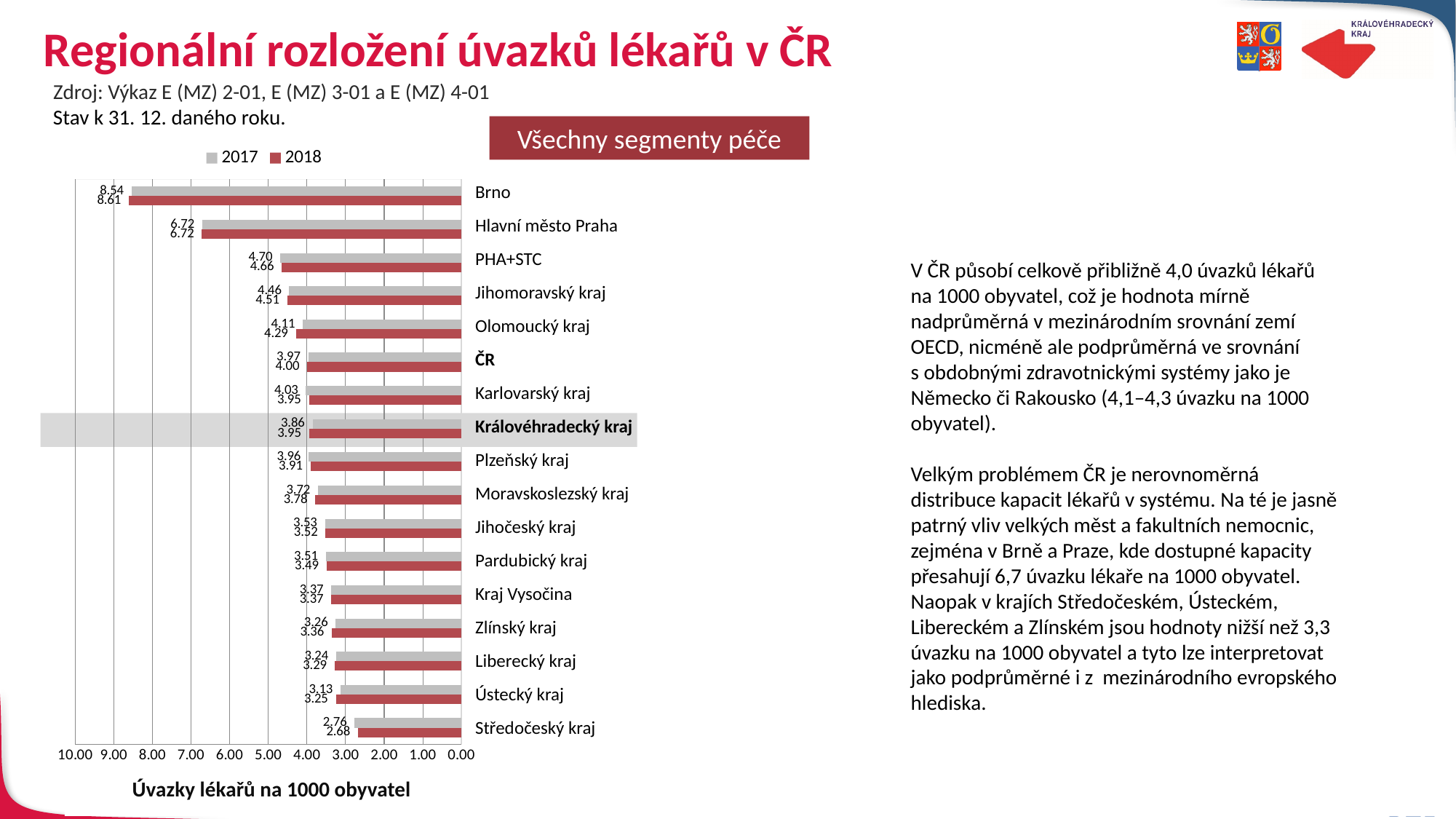
What type of chart is shown on the slide? bar chart Which is larger for Zlínský kraj, the 2017 value or the 2018 value? 2018 What is the difference between the 2018 values for Brno and Hlavní město Praha? 1.89 What is the difference between the 2018 and 2017 values for Olomoucký kraj? 0.18 What is the x-axis title of the chart? Úvazky lékařů na 1000 obyvatel How many categories (regions) are plotted in the chart? 17 What is the 2018 value for Královéhradecký kraj? 3.95 Which category has the lowest 2017 value? Středočeský kraj How many series does the chart legend list? 2 Which category has the highest 2018 value? Brno What is the 2017 value for Brno? 8.54 What is the 2018 value for ČR? 4.00